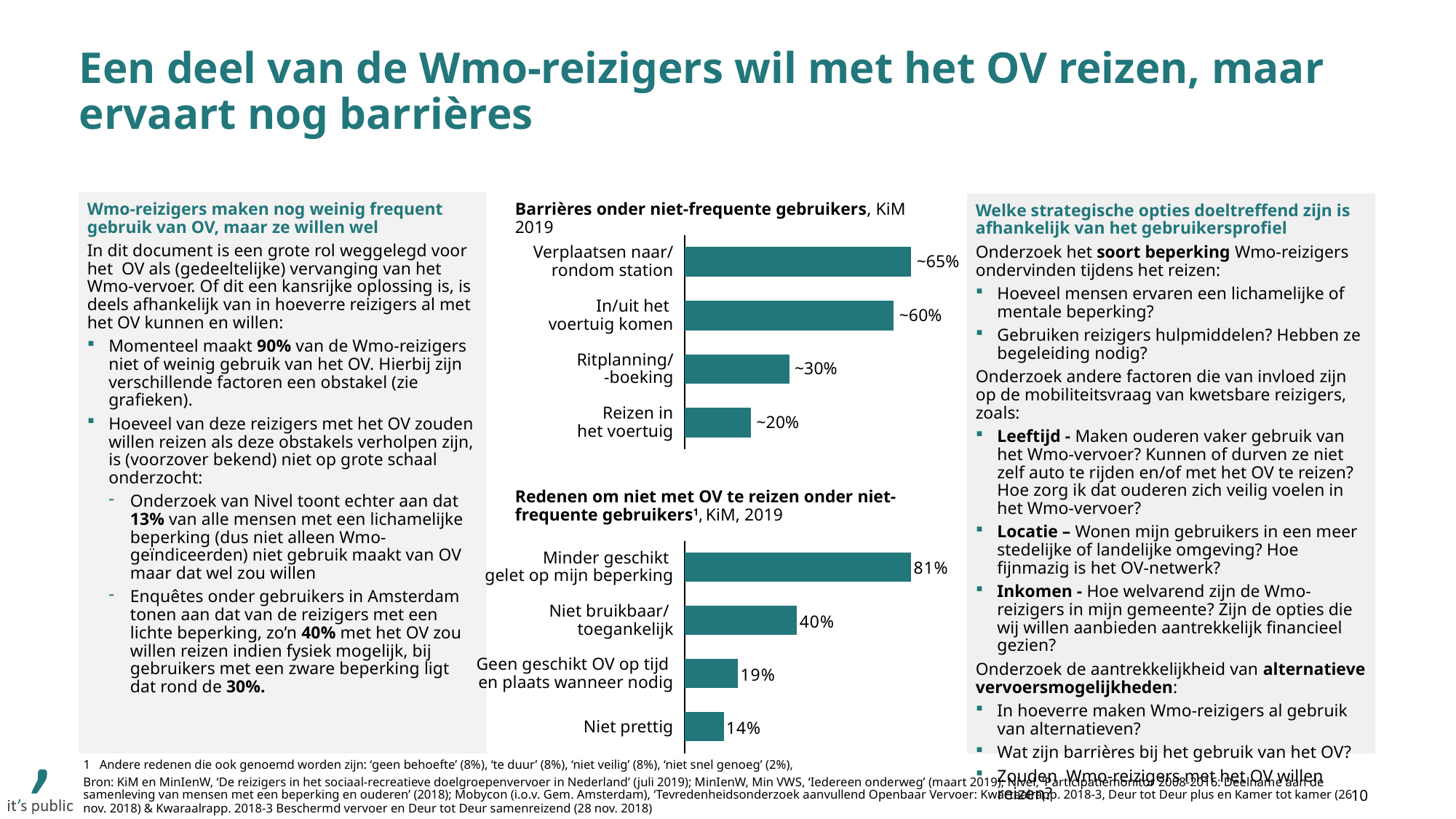
In the chart 'Barrières onder niet-frequente gebruikers', which is larger: 'In/uit het voertuig komen' or 'Ritplanning/-boeking'? In/uit het voertuig komen In the chart 'Barrières onder niet-frequente gebruikers', how many categories are shown? 4 What type of chart is 'Barrières onder niet-frequente gebruikers'? Bar chart In the chart 'Redenen om niet met OV te reizen onder niet-frequente gebruikers', what is the difference between 'Geen geschikt OV op tijd en plaats wanneer nodig' and 'Niet prettig'? 5 percentage points In the chart 'Redenen om niet met OV te reizen onder niet-frequente gebruikers', which category has the lowest value? Niet prettig In the chart 'Barrières onder niet-frequente gebruikers', which category has the highest value? Verplaatsen naar/rondom station In the chart 'Redenen om niet met OV te reizen onder niet-frequente gebruikers', what is the difference between 'Minder geschikt gelet op mijn beperking' and 'Niet bruikbaar/toegankelijk'? 41 percentage points In the chart 'Redenen om niet met OV te reizen onder niet-frequente gebruikers', what is the value for 'Niet prettig'? 14% In the chart 'Barrières onder niet-frequente gebruikers', which category has the lowest value? Reizen in het voertuig In the chart 'Redenen om niet met OV te reizen onder niet-frequente gebruikers', how many categories are shown? 4 In the chart 'Redenen om niet met OV te reizen onder niet-frequente gebruikers', what is the value for 'Minder geschikt gelet op mijn beperking'? 81% In the chart 'Redenen om niet met OV te reizen onder niet-frequente gebruikers', what is the value for 'Niet bruikbaar/toegankelijk'? 40%